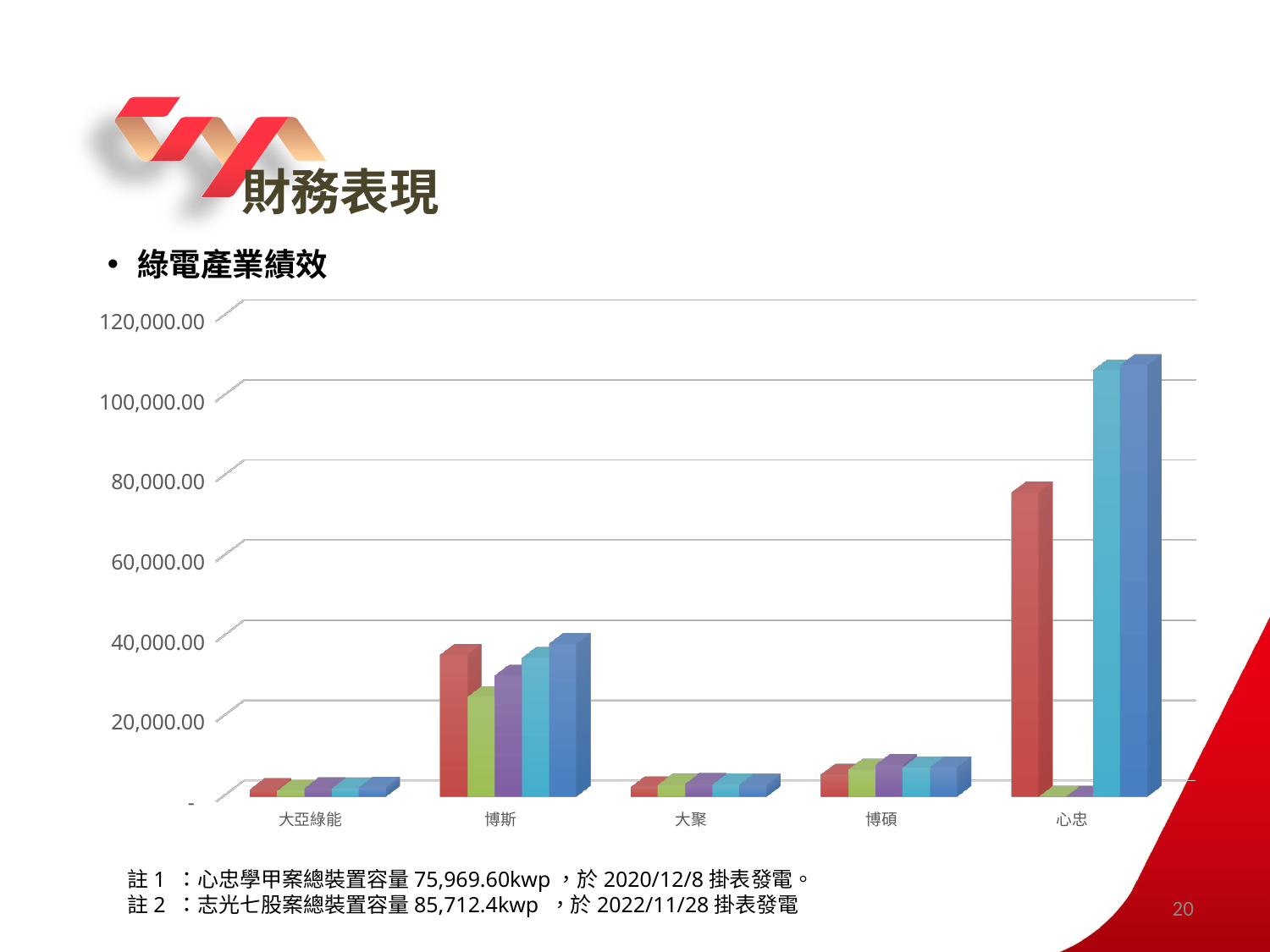
Are the bars for 博碩 greater or less than 20,000.00? less Is the value of the red (first) bar for 心忠 greater or less than 60,000.00? greater What is the highest value shown on the chart's vertical axis? 120,000.00 Is the value of the tallest bar for 心忠 greater or less than 100,000.00? greater Which category has the tallest bars in the chart? 心忠 Which category has larger bars, 博斯 or 大聚? 博斯 How many categories are shown on the x axis of the chart? 5 What kind of chart is shown on the slide? bar chart Which category has larger bars, 心忠 or 博斯? 心忠